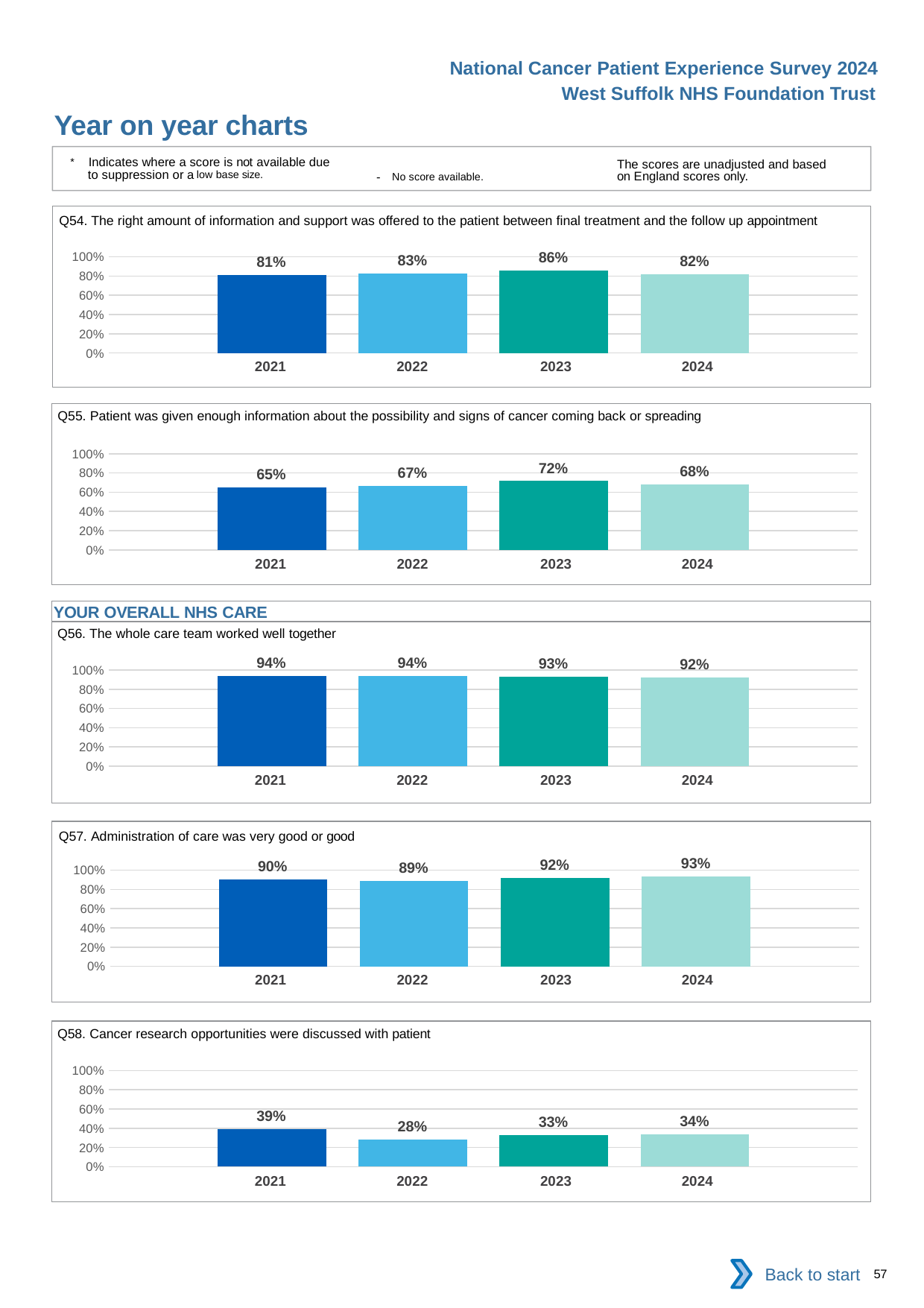
What is the section heading shown above the Q56 chart? YOUR OVERALL NHS CARE In the Q56 chart, what is the difference between the 2021 value and the 2024 value? 2% In the Q58 chart, what is the difference between the 2021 value and the 2022 value? 11% In the Q54 chart, what is the value for 2023? 86% In the Q57 chart, which year has the highest value? 2024 In the Q55 chart, which is larger, the value for 2022 or the value for 2024? 2024 In the Q56 chart, do the values rise or fall from 2022 to 2024? fall What kind of chart is the Q55 chart? bar chart In the Q58 chart, is the value for 2021 greater or less than 60%? less In the Q54 chart, how many years are plotted? 4 In the Q55 chart, which year has the lowest value? 2021 In the Q58 chart, what is the value for 2022? 28%